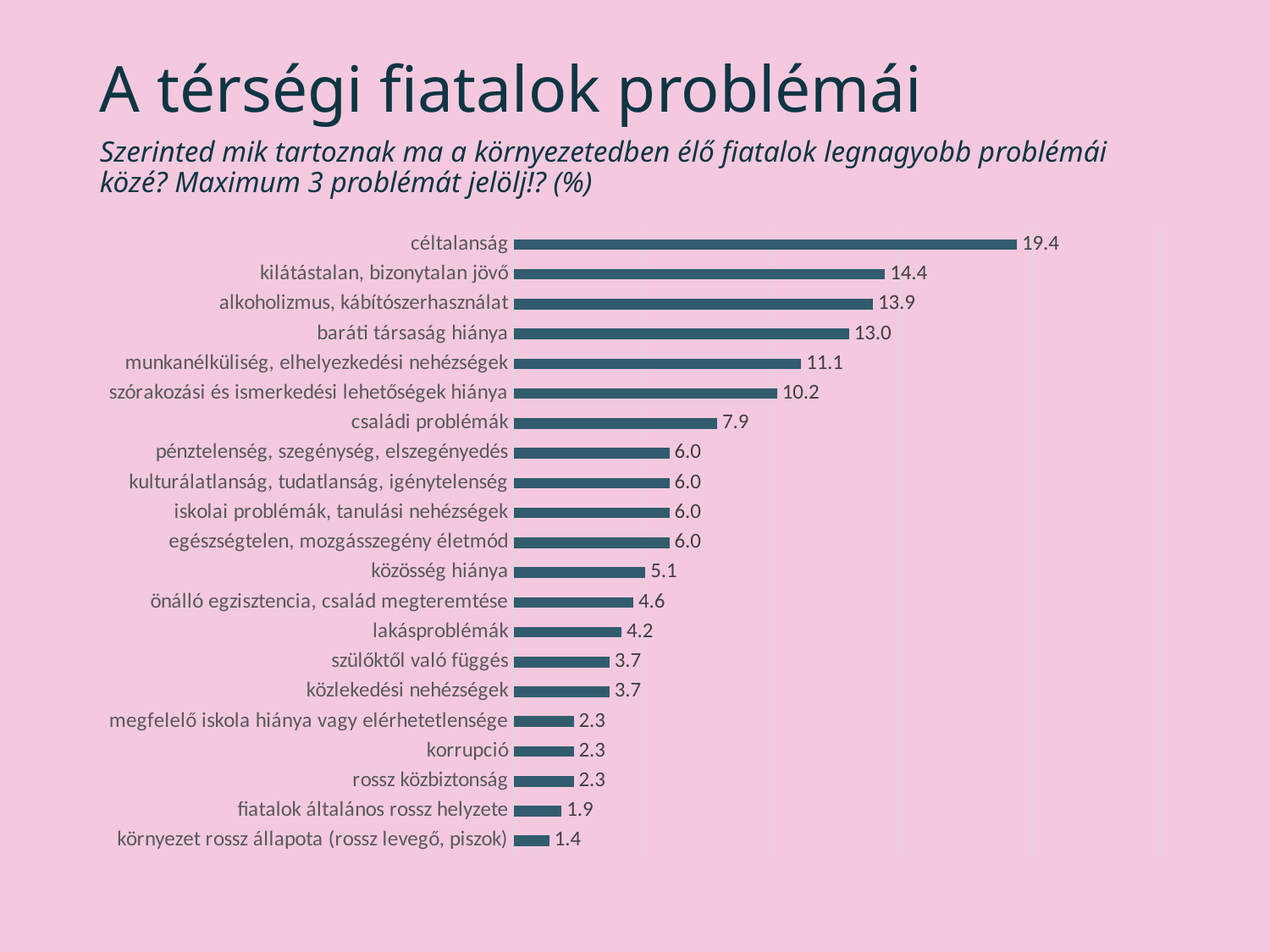
Which category has the highest value? céltalanság What is the value for céltalanság? 19.4 What kind of chart is shown on the slide? bar chart How many categories are shown in the chart? 21 What is the difference between the values for céltalanság and kilátástalan, bizonytalan jövő? 5.0 What is the value for munkanélküliség, elhelyezkedési nehézségek? 11.1 What is the value for lakásproblémák? 4.2 What is the difference between the values for családi problémák and közösség hiánya? 2.8 Which is larger, the value for baráti társaság hiánya or the value for szórakozási és ismerkedési lehetőségek hiánya? baráti társaság hiánya How many categories have a value of 6.0? 4 Which category has the lowest value? környezet rossz állapota (rossz levegő, piszok) What is the title of the slide? A térségi fiatalok problémái